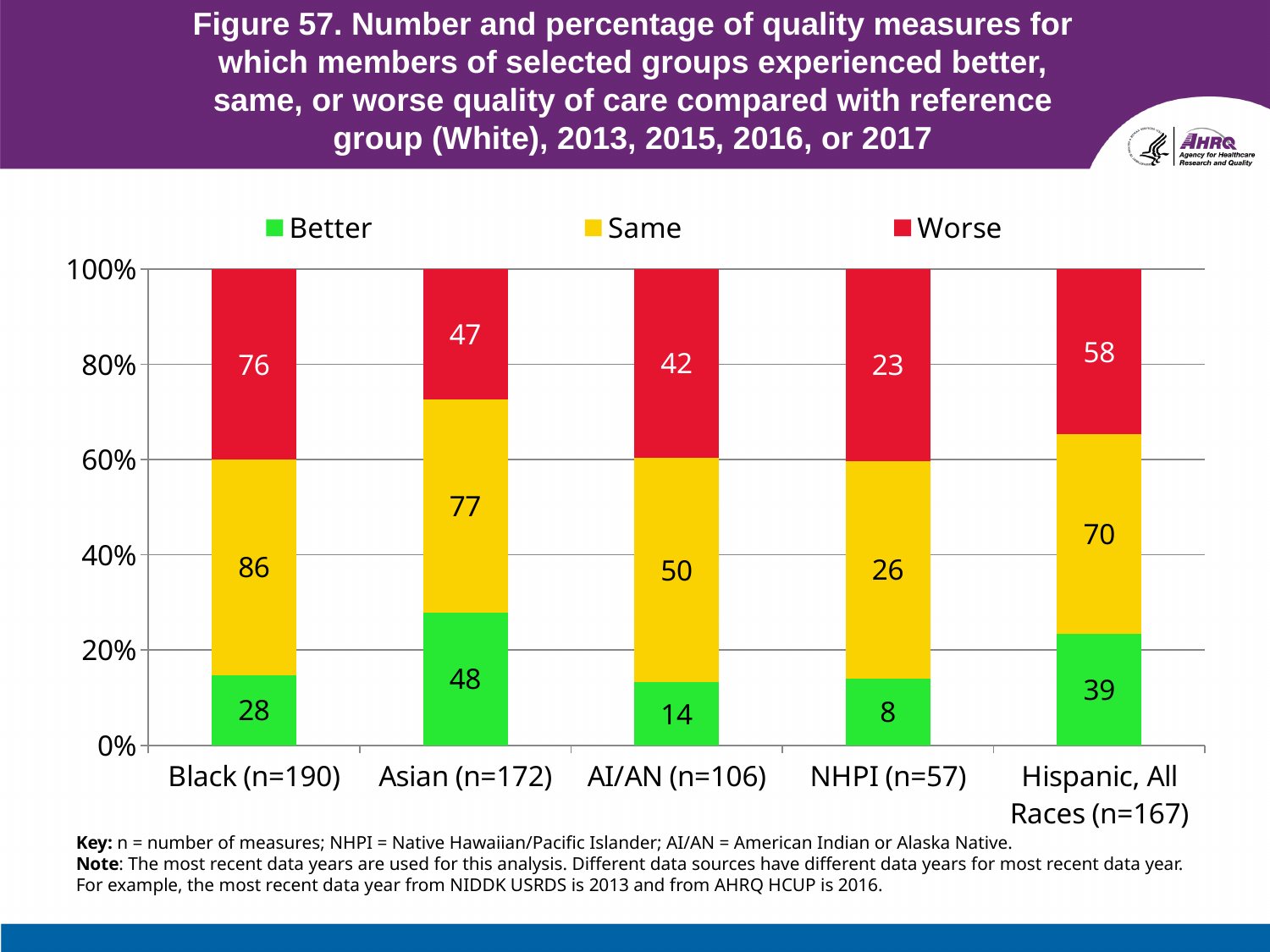
How many series does the legend list? 3 Which colour represents the 'Worse' series in the legend? Red Which group has the highest 'Better' value? Asian (n=172) What kind of chart is shown on the slide? Stacked bar chart Which group has the lowest 'Worse' value? NHPI (n=57) How many groups are shown on the x axis? 5 Which is larger: the 'Worse' value for Black (n=190) or the 'Worse' value for Hispanic, All Races (n=167)? Black (n=190) What is the total of the three segments in the AI/AN (n=106) bar? 106 What is the 'Better' value for NHPI (n=57)? 8 What is the 'Worse' value for Asian (n=172)? 47 What is the difference between the 'Same' and 'Better' values for Hispanic, All Races (n=167)? 31 What is the number of measures for which Black members experienced the same quality of care as the reference group? 86